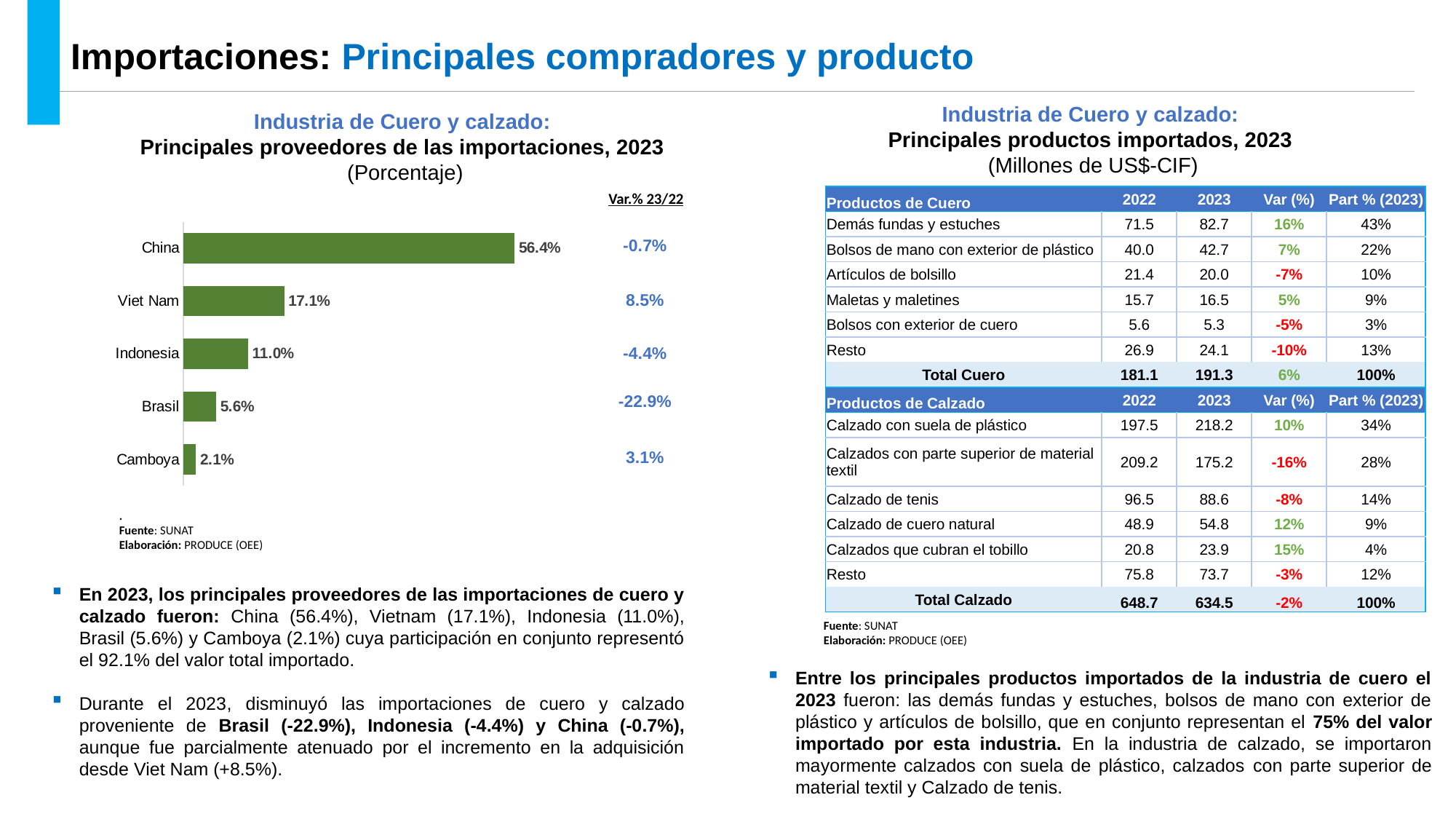
What is the value for Indonesia in the bar chart? 11.0% Which has a larger share in the bar chart, Viet Nam or Indonesia? Viet Nam What is the value for Camboya in the bar chart? 2.1% What is the difference between the shares of China and Viet Nam in the bar chart? 39.3% What is the value for Viet Nam in the bar chart? 17.1% Which country has the lowest share in the bar chart? Camboya How many countries are shown in the bar chart? 5 What type of chart is used to show the principal import suppliers? Bar chart What is the Var.% 23/22 shown next to Brasil in the bar chart? -22.9% What is the difference between the shares of Indonesia and Brasil in the bar chart? 5.4% What is the value for China in the bar chart of principal import suppliers? 56.4% Which country has the highest share in the bar chart? China